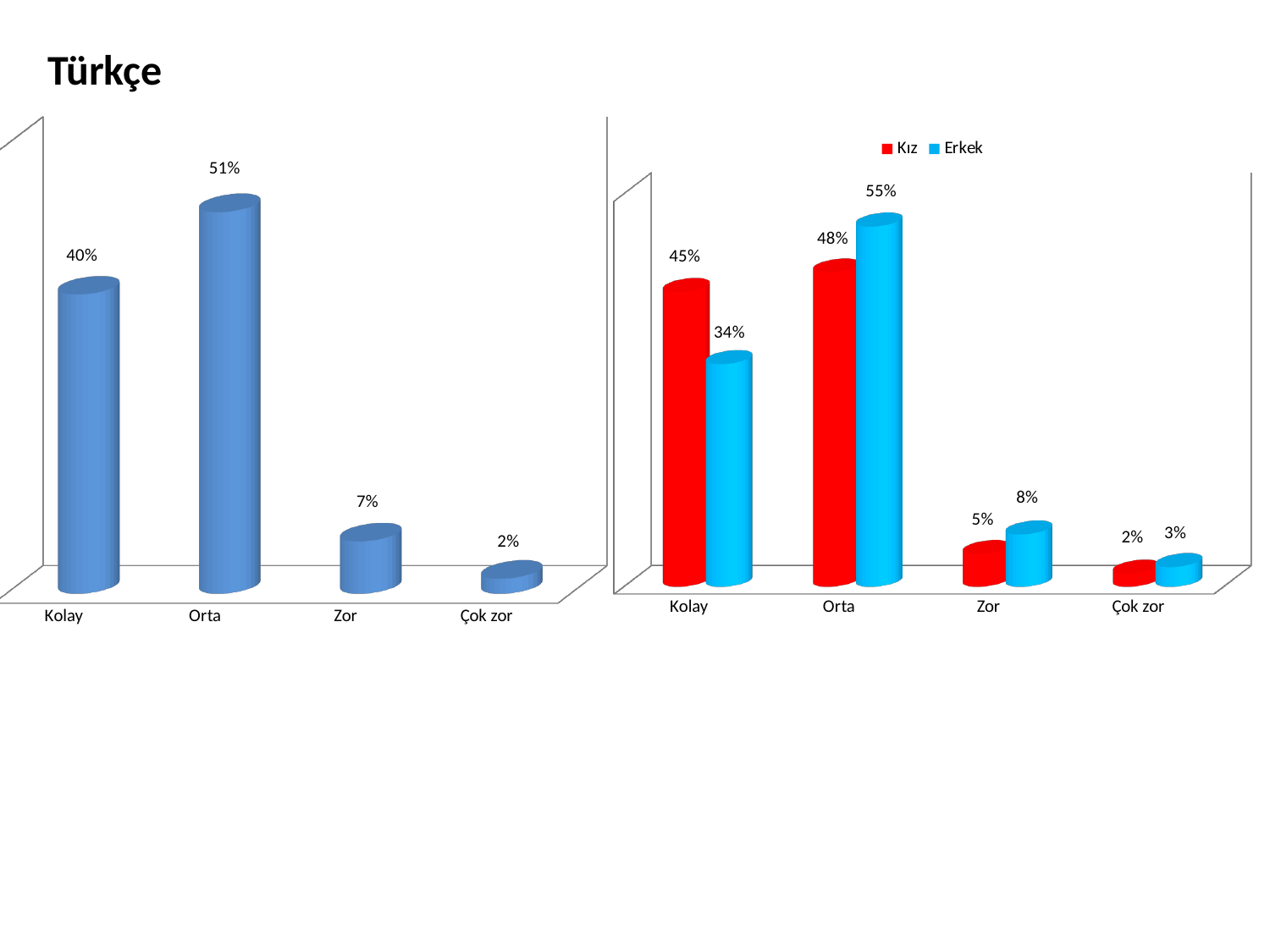
In the right chart, what is the Erkek value for Kolay? 34% In the right chart, what is the Kız value for Zor? 5% In the left chart, what is the difference between the values for Orta and Kolay? 11% In the left chart, what is the value for Orta? 51% In the right chart, which category has the highest Erkek value? Orta In the left chart, how many categories are shown on the x axis? 4 In the right chart, what is the difference between the Erkek and Kız values for Orta? 7% In the left chart, which category has the lowest value? Çok zor In the right chart, which is larger for Kolay, Kız or Erkek? Kız In the right chart, how many series does the legend list? 2 In the right chart, which colour represents the Kız series? Red What kind of chart is the left chart? Bar chart